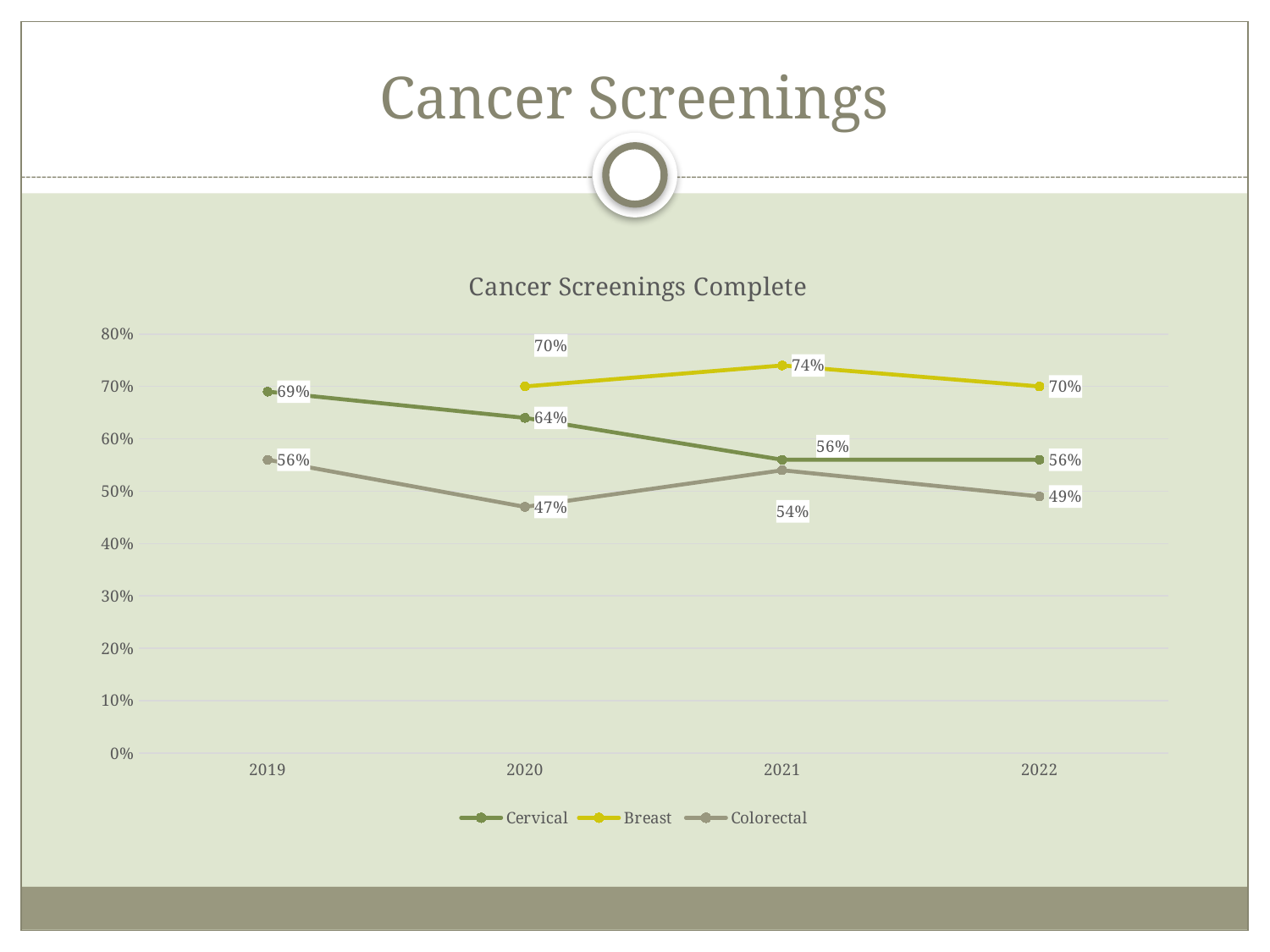
What type of chart is shown on the slide? line chart What is the Colorectal screening value for 2020? 47% In which year is the Breast screening value highest? 2021 How many years are shown on the x axis? 4 What is the Breast screening value for 2021? 74% What is the title of the chart? Cancer Screenings Complete What is the Cervical screening value for 2019? 69% In which year is the Colorectal screening value lowest? 2020 How many series does the legend list? 3 Which is larger in 2022, the Breast value or the Colorectal value? Breast Does the Cervical series rise or fall from 2019 to 2021? fall What is the difference between the Cervical value in 2019 and in 2022? 13%